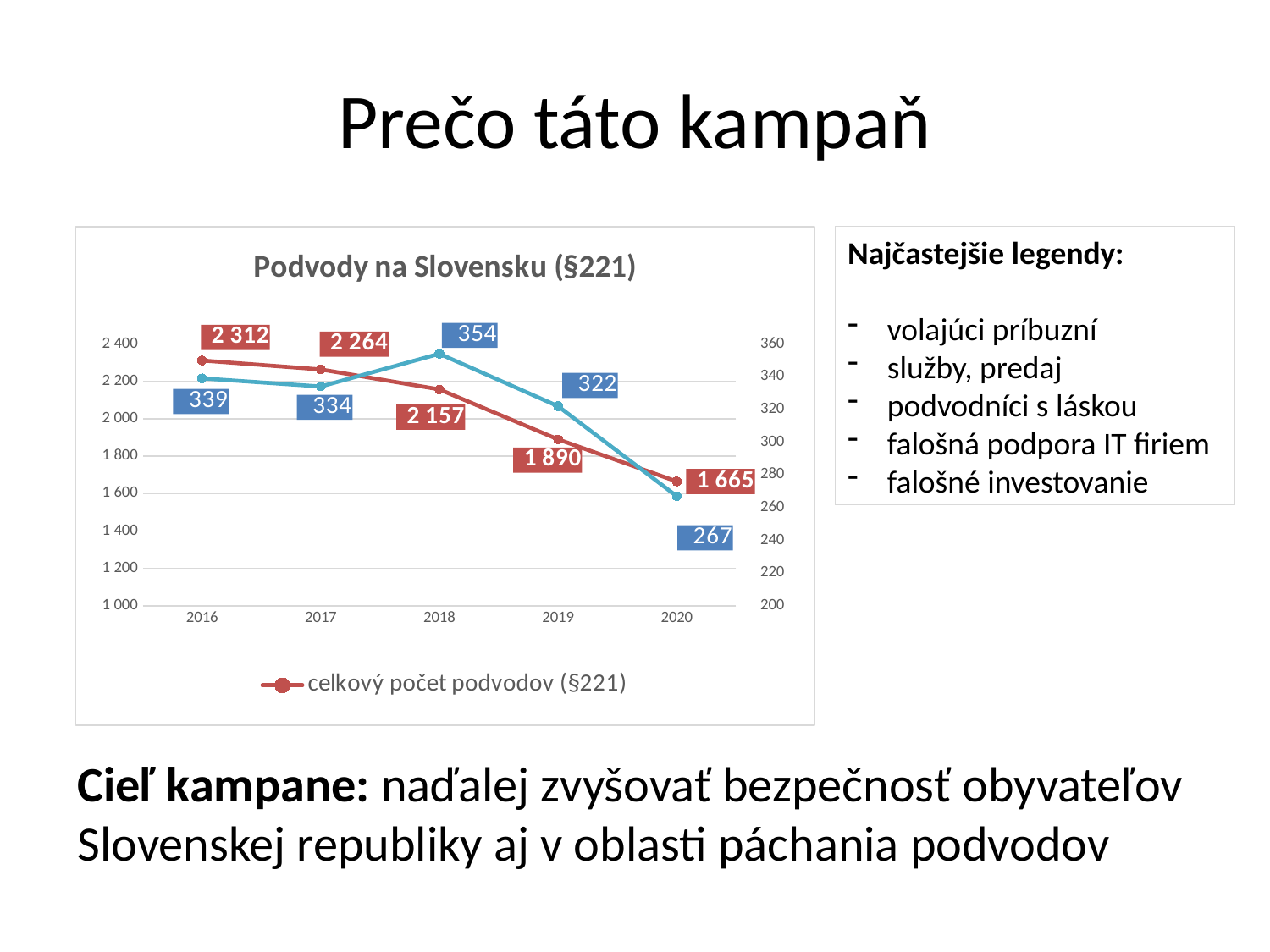
What is the value of celkový počet podvodov (§221) in 2020? 1 665 How many series does the chart legend list? 1 Does celkový počet podvodov (§221) rise or fall from 2016 to 2020? fall What is the value of celkový počet podvodov (§221) in 2018? 2 157 What is the value of celkový počet podvodov (§221) in 2016? 2 312 In which year is celkový počet podvodov (§221) lowest? 2020 What is the title of the chart? Podvody na Slovensku (§221) Which year has a larger value of celkový počet podvodov (§221), 2017 or 2019? 2017 What type of chart is shown on the slide? line chart In which year is celkový počet podvodov (§221) highest? 2016 What is the difference between celkový počet podvodov (§221) in 2016 and in 2020? 647 How many years are shown on the x axis of the chart? 5